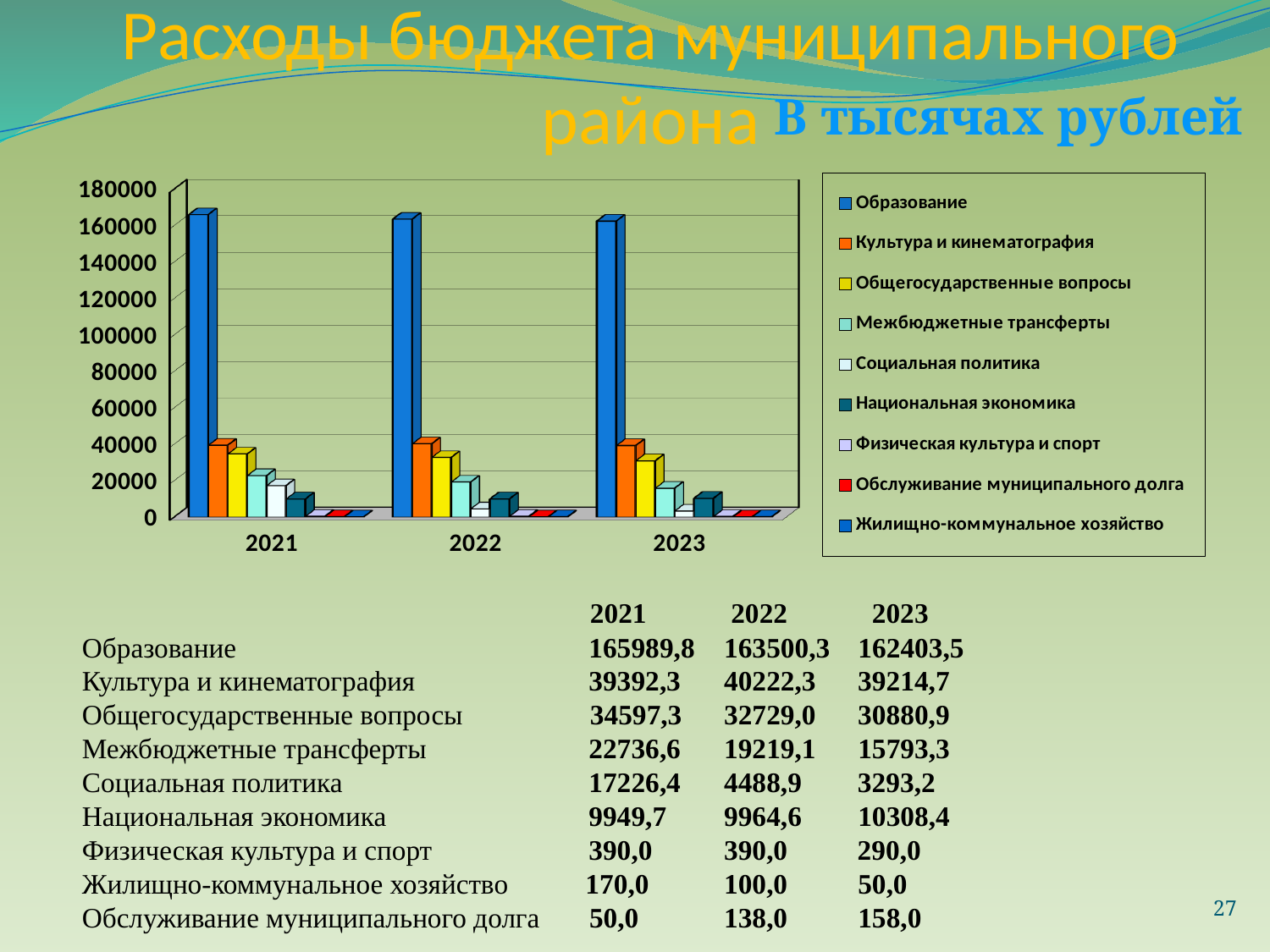
Which series has the lowest value in 2021? Обслуживание муниципального долга Do the values for Межбюджетные трансферты rise or fall from 2021 to 2023? fall Is the value for Образование in 2022 greater or less than 160000? greater What is the value for Социальная политика in 2022? 4488,9 What is the difference between the Образование values for 2021 and 2023? 3586,3 How many year categories are shown on the x axis of the chart? 3 How many series does the chart legend list? 9 What kind of chart is shown on the slide? bar chart Which series has the highest value in 2023? Образование What is the value for Образование in 2021? 165989,8 What is the value for Межбюджетные трансферты in 2023? 15793,3 Which is larger, Культура и кинематография in 2022 or Общегосударственные вопросы in 2022? Культура и кинематография